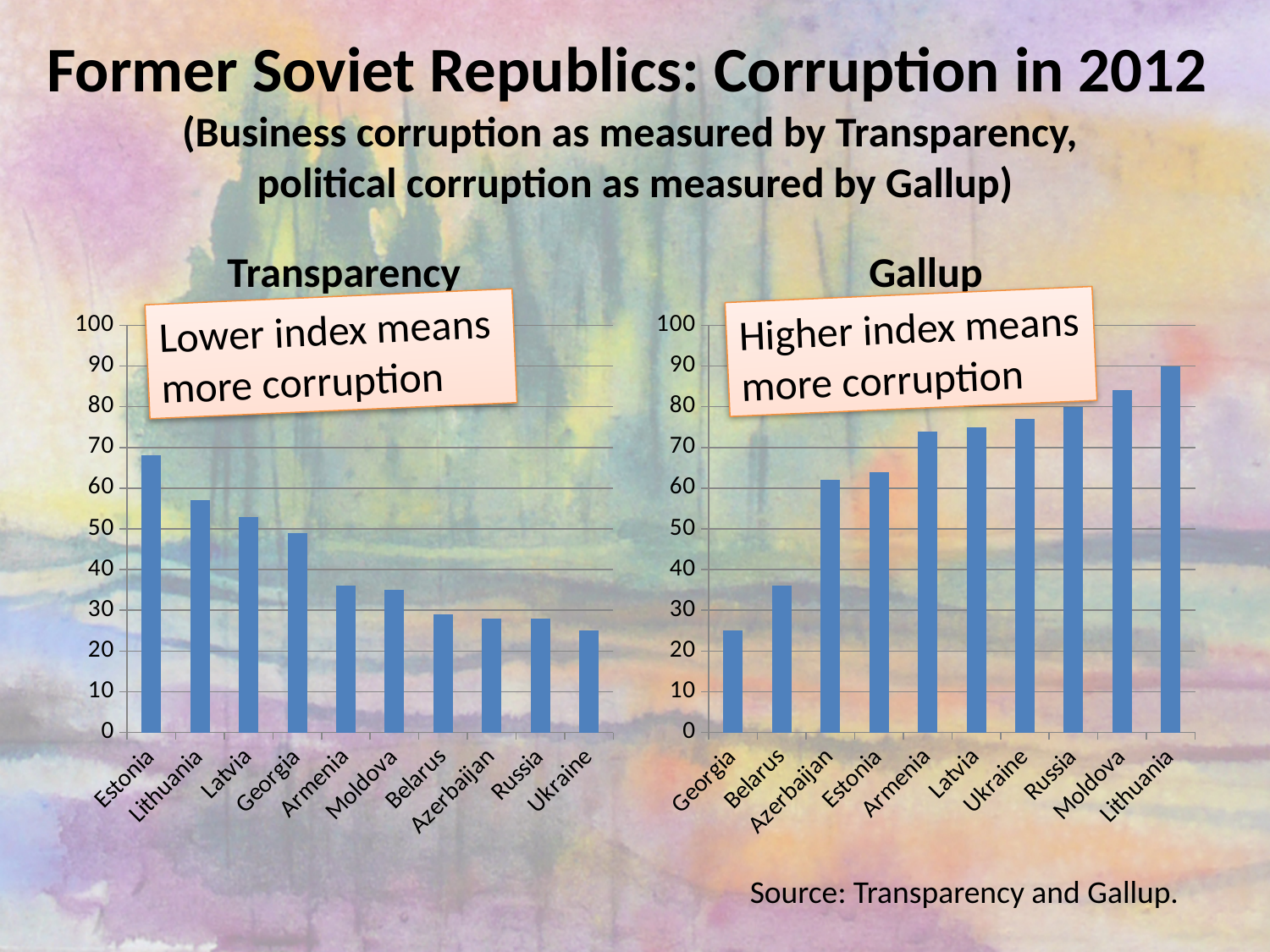
How many countries are shown in the Transparency chart? 10 In the Transparency chart, is the value for Ukraine greater or less than 30? less In the Gallup chart, is the value for Belarus greater or less than 40? less Do the values in the Gallup chart rise or fall from left to right? rise In the Transparency chart, which is larger, the value for Lithuania or the value for Armenia? Lithuania In the Gallup chart, which country has the lowest value? Georgia In the Transparency chart, which country has the highest value? Estonia How many countries are shown in the Gallup chart? 10 In the Gallup chart, which country has the highest value? Lithuania What kind of chart is the Transparency chart? bar chart In the Transparency chart, is the value for Estonia greater or less than 60? greater